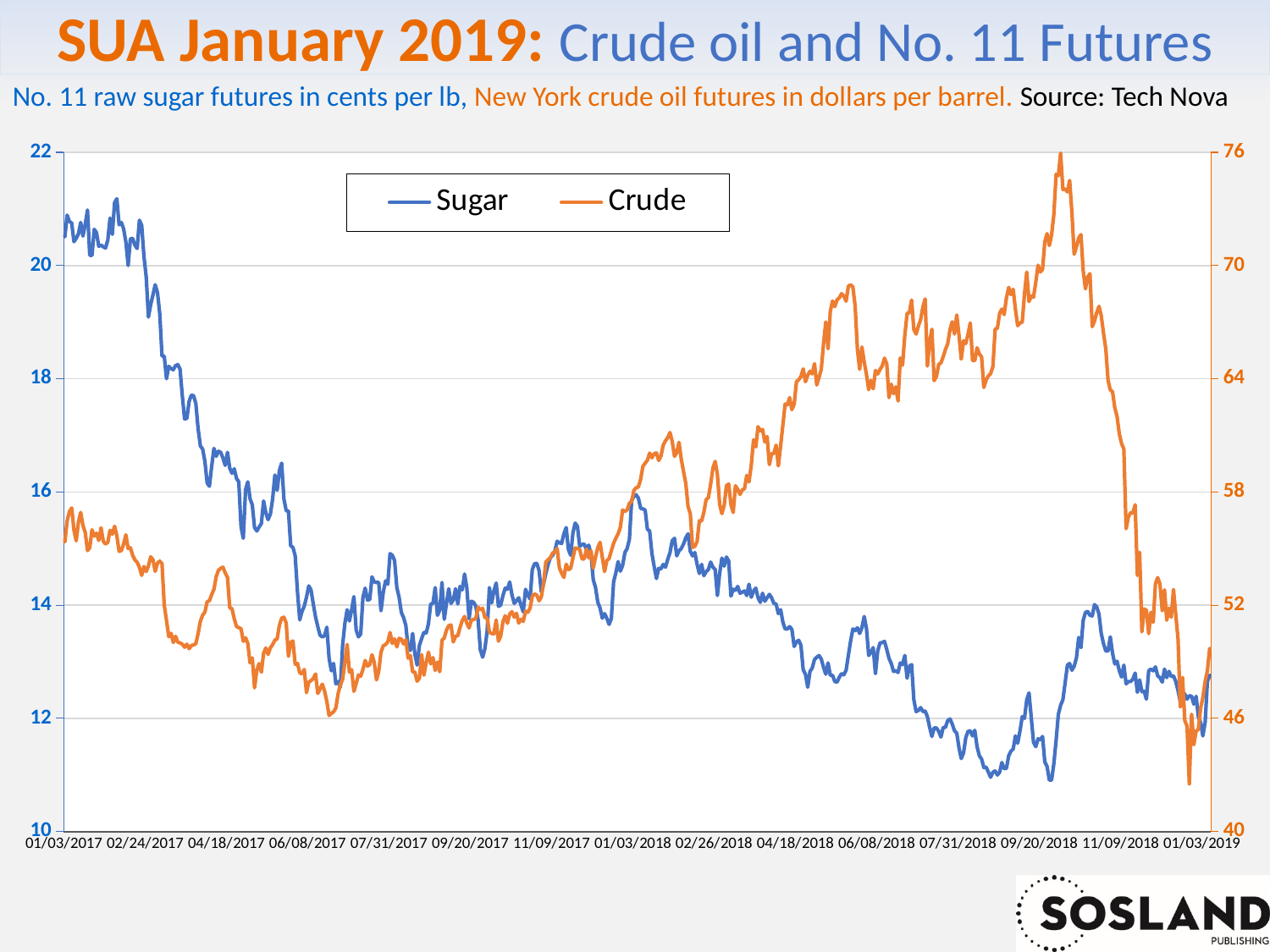
Does the Sugar line rise or fall between 01/03/2017 and 06/08/2017? fall Is the value for Crude at the start of the chart (01/03/2017) greater or less than 58? less Does the Crude line rise or fall between 09/20/2018 and 11/09/2018? fall Does the Crude line rise or fall between 06/08/2017 and 09/20/2018? rise What kind of chart is shown on the slide? line chart Which series is plotted in orange? Crude Is the value for Sugar at the end of the chart (01/03/2019) greater or less than 14? less Is the peak value of Crude around 09/20/2018 greater or less than 70? greater How many series does the legend list? 2 What are the two series named in the legend? Sugar and Crude